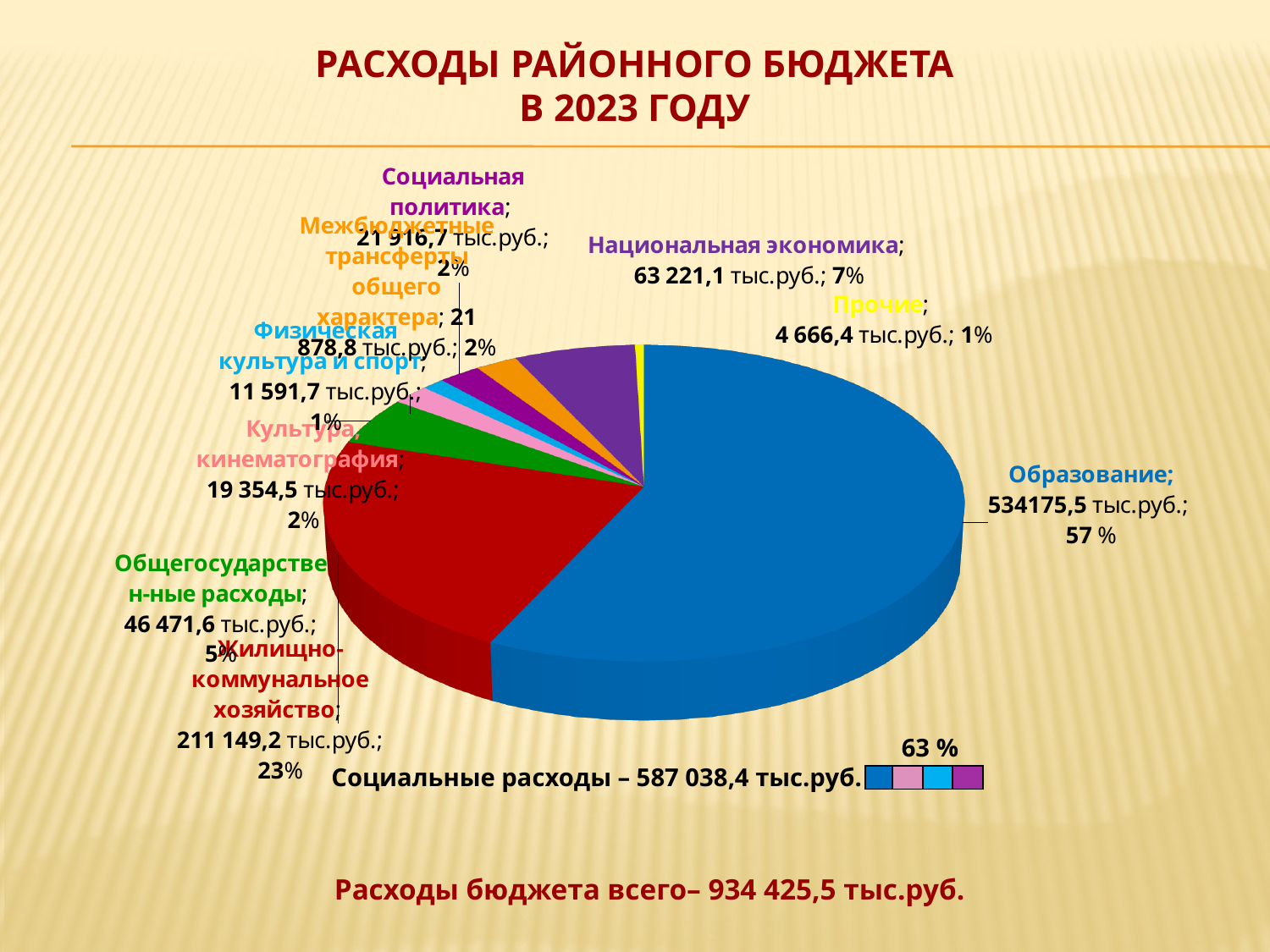
How many categories are shown in the pie chart? 9 Which category has the largest slice of the pie? Образование What is the title of the chart on the slide? Расходы районного бюджета в 2023 году What is the value for Образование? 534175,5 тыс.руб. Which category has the smallest slice of the pie? Прочие What is the difference between the values for Образование and Жилищно-коммунальное хозяйство? 323 026,3 тыс.руб. What is the value for Национальная экономика? 63 221,1 тыс.руб. Which is larger, Национальная экономика or Общегосударственные расходы? Национальная экономика What kind of chart is shown on the slide? pie chart What share of the pie does Образование take? 57 % What share of the pie does Жилищно-коммунальное хозяйство take? 23% What is the value for Общегосударственные расходы? 46 471,6 тыс.руб.